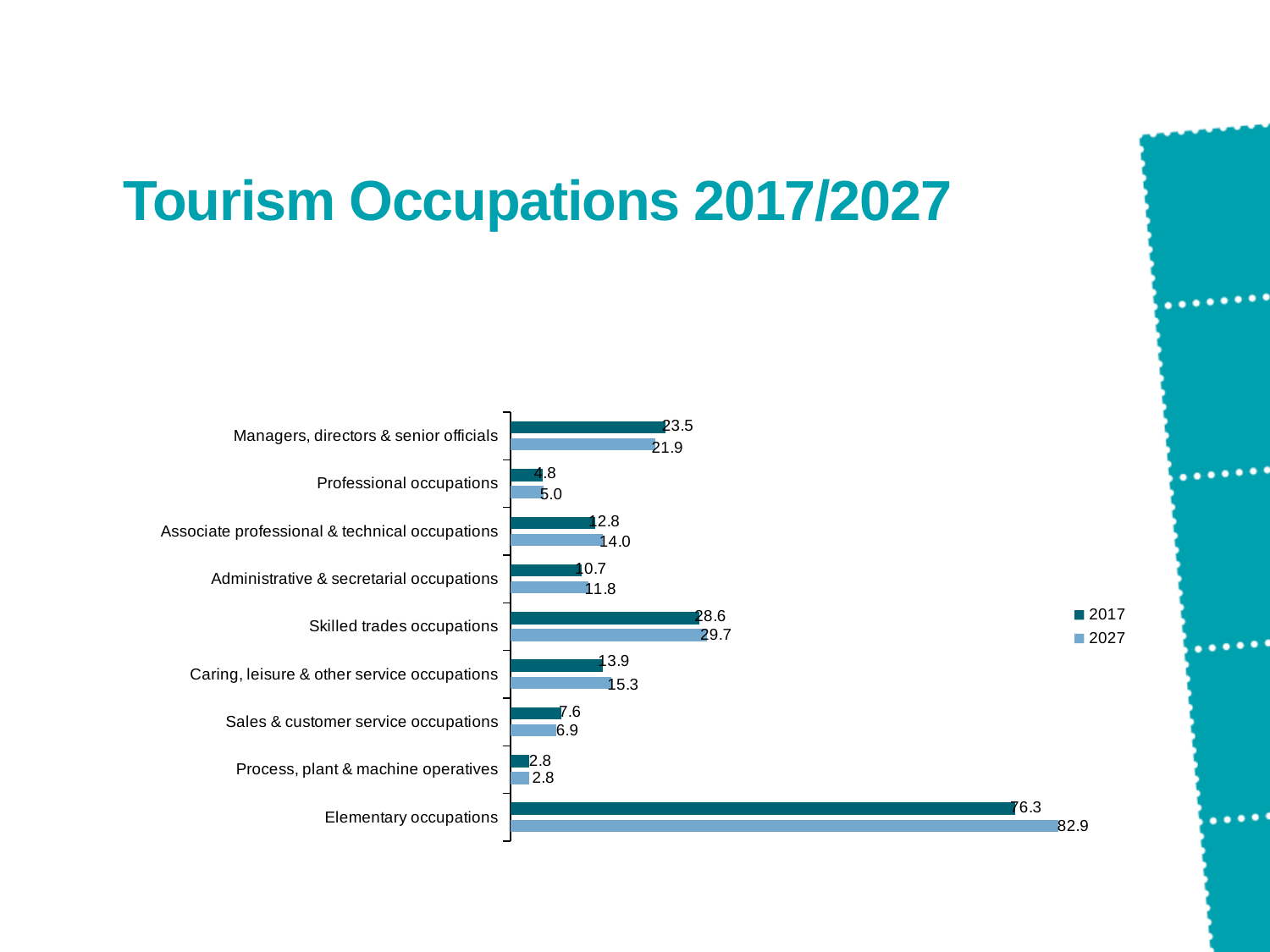
What is the title of the slide? Tourism Occupations 2017/2027 What is the 2027 value for Managers, directors & senior officials? 21.9 For Sales & customer service occupations, which is larger: the 2017 value or the 2027 value? 2017 What is the 2017 value for Elementary occupations? 76.3 What is the 2027 value for Skilled trades occupations? 29.7 How many occupation categories are shown on the chart? 9 Which occupation has the lowest 2017 value? Process, plant & machine operatives What kind of chart is shown on the slide? Bar chart What is the difference between the 2017 and 2027 values for Managers, directors & senior officials? 1.6 What is the difference between the 2027 and 2017 values for Elementary occupations? 6.6 Which occupation has the highest 2027 value? Elementary occupations How many series does the legend list? 2